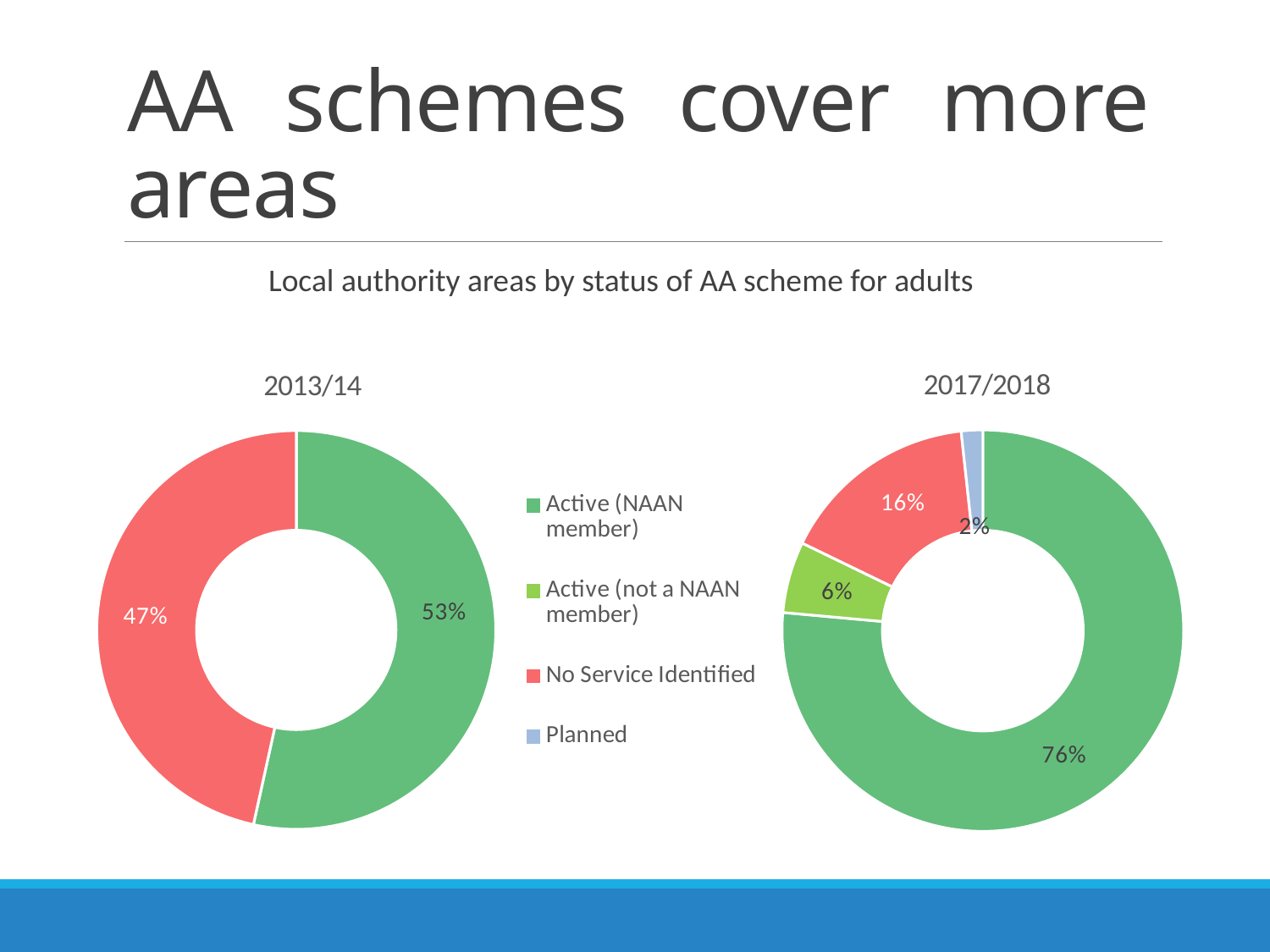
What kind of chart is used on this slide? Doughnut (pie) chart What is the difference between the Active (NAAN member) share in 2017/2018 and in 2013/14? 23 percentage points In the 2017/2018 chart, what share of local authority areas is Active (not a NAAN member)? 6% In the 2017/2018 chart, which category has the smallest share? Planned In the 2017/2018 chart, what share of local authority areas is Active (NAAN member)? 76% How many categories does the legend list? 4 In the 2013/14 chart, which is larger: Active (NAAN member) or No Service Identified? Active (NAAN member) In the 2017/2018 chart, what share of local authority areas is Planned? 2% In the 2013/14 chart, what share of local authority areas has No Service Identified? 47% In the 2013/14 chart, what share of local authority areas is Active (NAAN member)? 53% In the 2017/2018 chart, which category has the largest share? Active (NAAN member) In the 2017/2018 chart, what share of local authority areas has No Service Identified? 16%